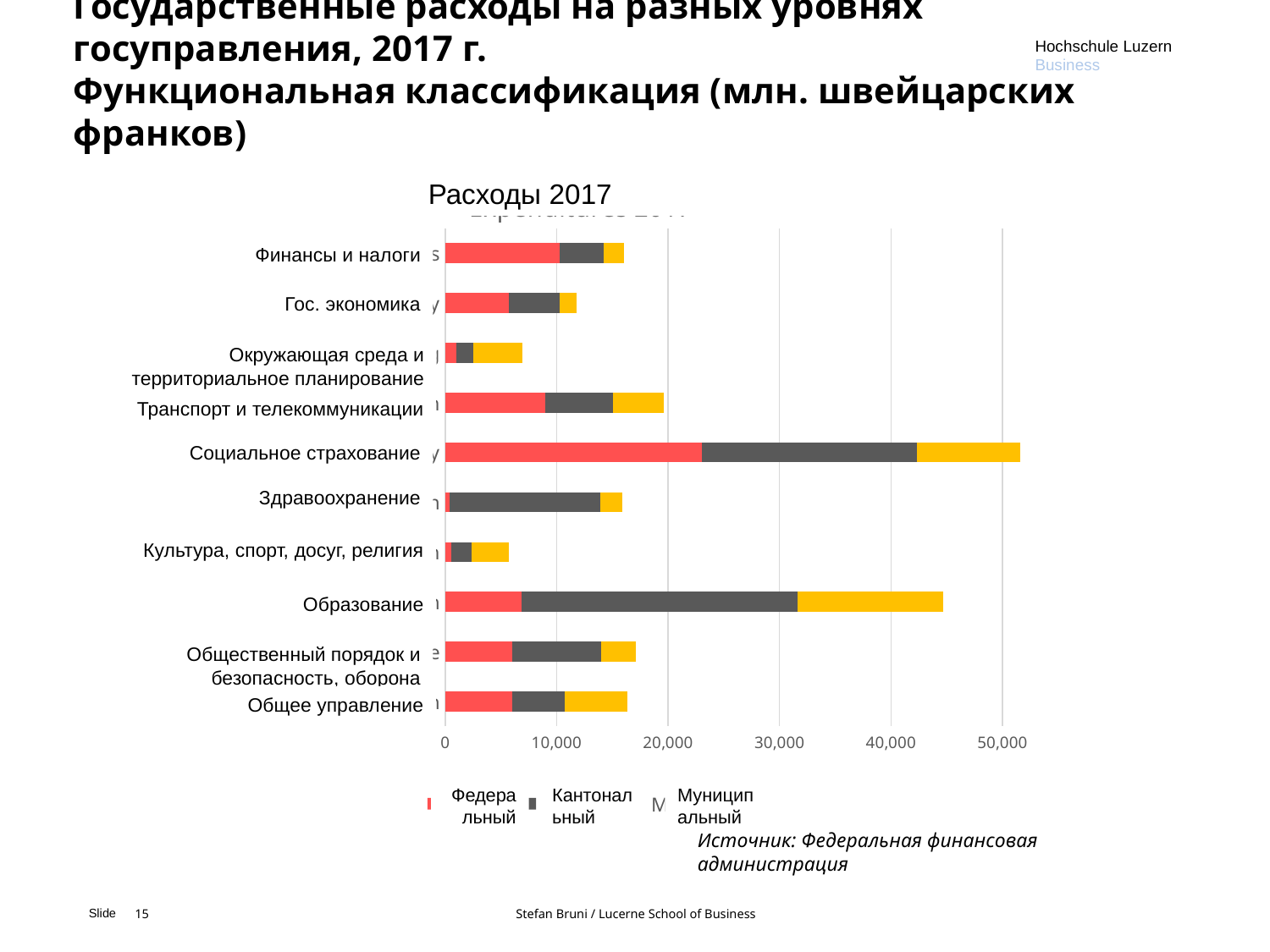
What kind of chart is shown on the slide? Stacked bar chart Which has a larger total: Образование or Транспорт и телекоммуникации? Образование Which category has the largest Кантональный segment? Образование Which category has the highest total expenditure? Социальное страхование Is the total value for Здравоохранение greater or less than 20,000? less Is the total value for Образование greater or less than 40,000? greater Is the total value for Социальное страхование greater or less than 50,000? greater How many series does the legend list? 3 Which category has the largest Федеральный segment? Социальное страхование What is the title of the chart? Расходы 2017 How many categories are plotted in the chart? 10 Which colour represents the Муниципальный series? Yellow